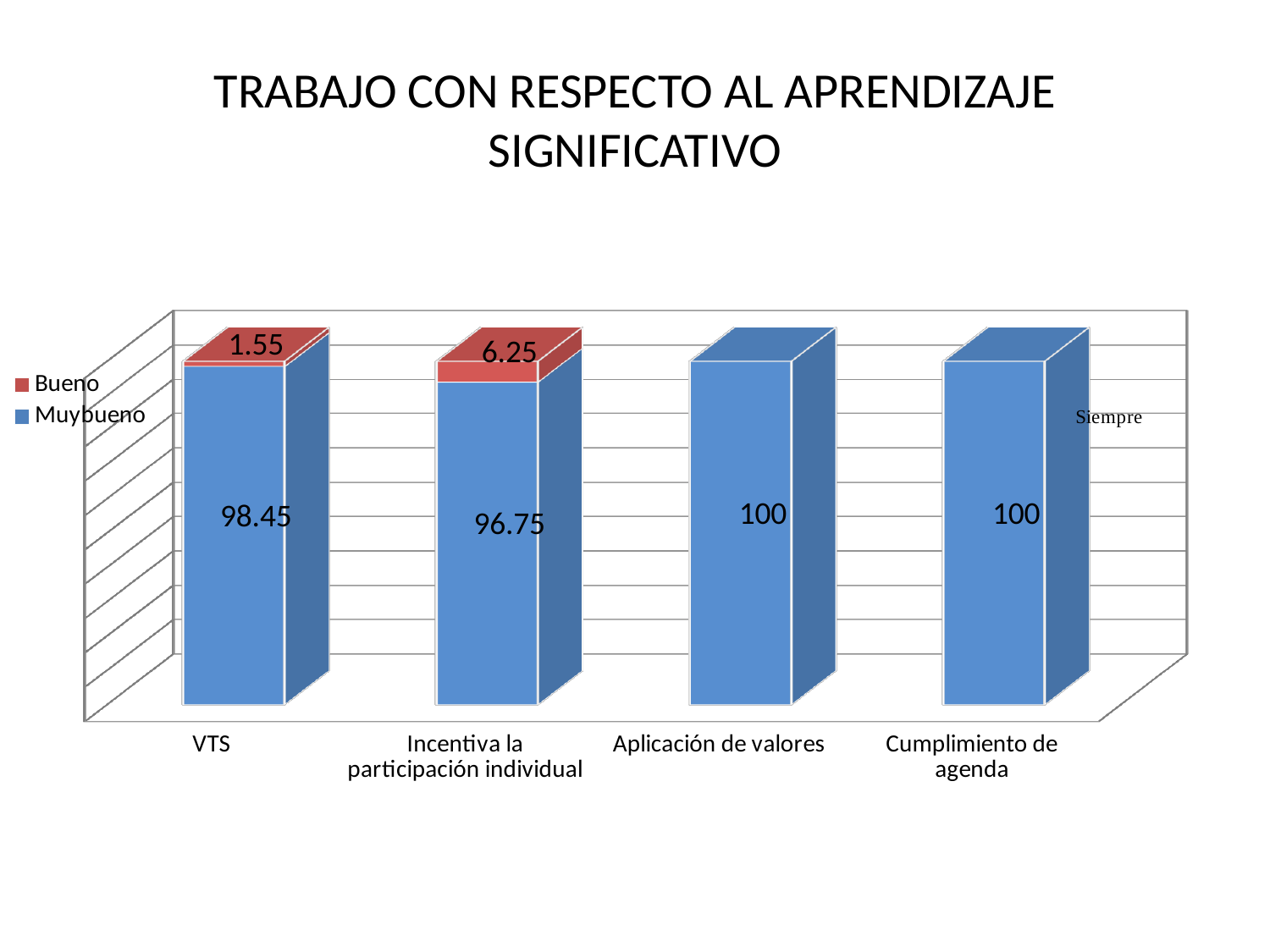
What is the Muybueno value for VTS? 98.45 Which is larger, the Bueno value for VTS or the Bueno value for Incentiva la participación individual? Incentiva la participación individual What is the Bueno value for VTS? 1.55 What is the Muybueno value for Aplicación de valores? 100 What kind of chart is shown on the slide? Stacked bar chart Which category has the lowest Muybueno value? Incentiva la participación individual What is the difference between the Muybueno values for VTS and Incentiva la participación individual? 1.7 Which category has the highest Bueno value? Incentiva la participación individual How many categories are shown on the x axis? 4 What is the Muybueno value for Incentiva la participación individual? 96.75 How many series does the legend list? 2 What is the Bueno value for Incentiva la participación individual? 6.25